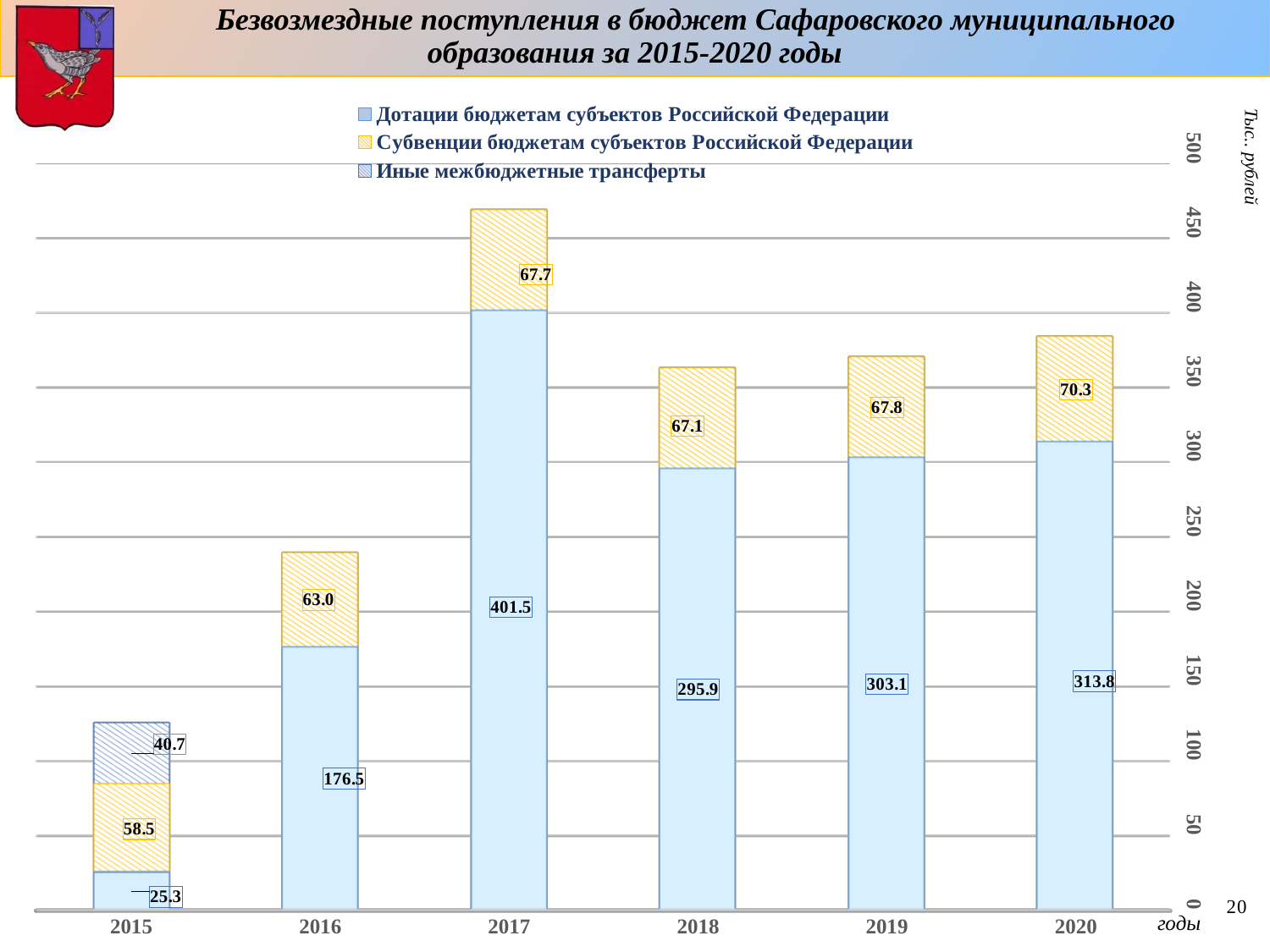
How many series does the legend list? 3 How many years are shown on the x axis? 6 What is the value of Субвенции бюджетам субъектов Российской Федерации for 2020? 70.3 What is the value of Дотации бюджетам субъектов Российской Федерации for 2017? 401.5 Which is larger: the Субвенции value for 2018 or for 2019? 2019 What kind of chart is shown on the slide? stacked bar chart What is the difference between the Дотации values for 2020 and 2019? 10.7 What is the total of the stacked bar for 2016? 239.5 Which year has the highest value for Дотации бюджетам субъектов Российской Федерации? 2017 Which year has the lowest value for Субвенции бюджетам субъектов Российской Федерации? 2015 What is the value of Иные межбюджетные трансферты for 2015? 40.7 Is the total height of the 2017 bar greater or less than 450? greater